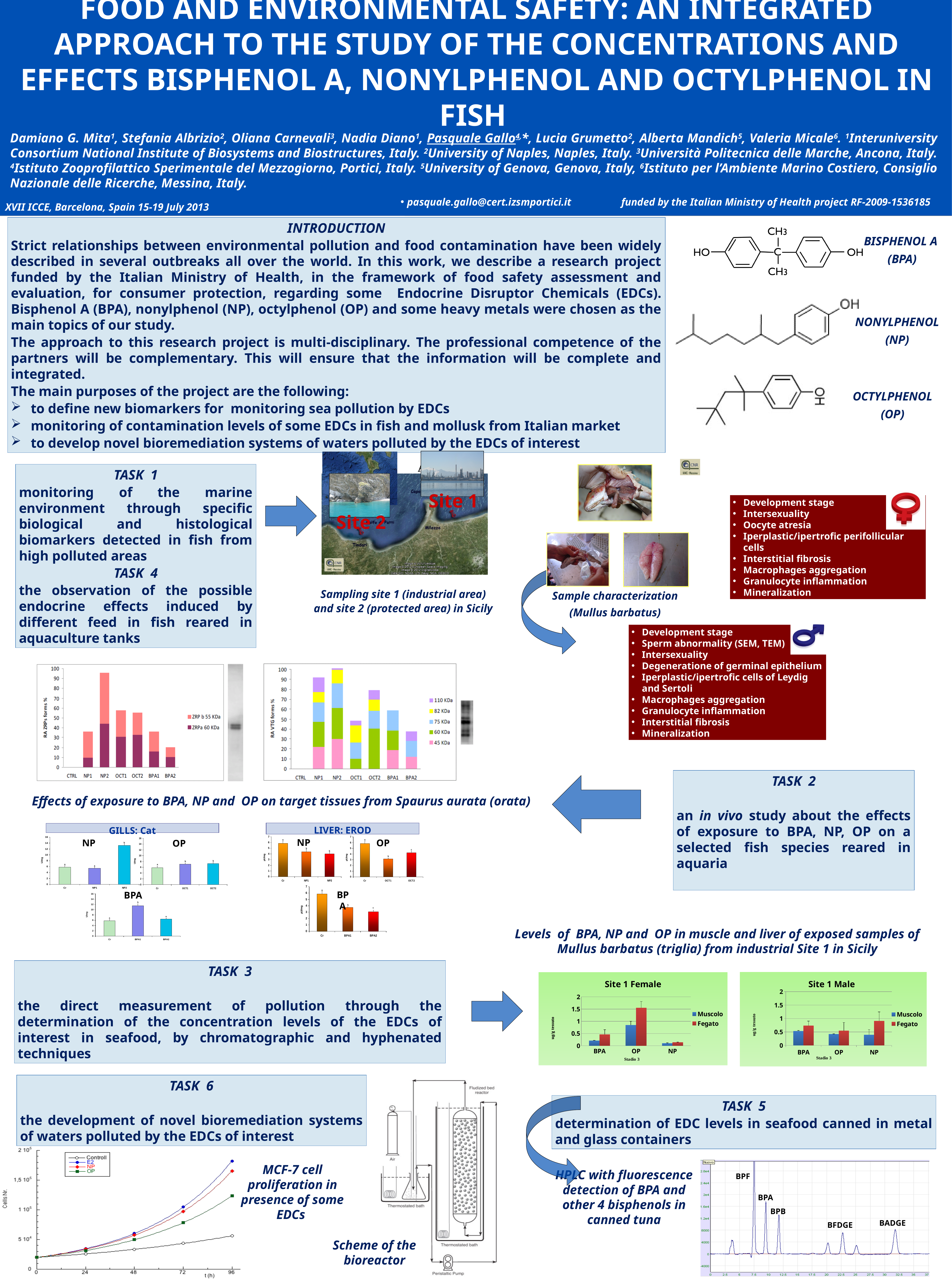
How many categories are shown on the x axis of the 'RA ZRPs forms %' chart? 7 In the 'RA ZRPs forms %' chart, is the total bar for NP2 greater or less than 80? greater What kind of chart is the 'RA ZRPs forms %' chart on the left of the poster? bar chart In the MCF-7 cell proliferation line chart at the bottom left, do the cell numbers rise or fall as t(h) increases? rise In the 'RA ZRPs forms %' chart, is the total bar for BPA2 greater or less than 30? less How many series does the legend of the 'Site 1 Male' chart list? 2 In the 'Site 1 Female' chart, which category has the highest Fegato value? OP How many series does the legend of the 'RA VTG forms %' chart list? 5 In the 'Site 1 Female' chart, which is larger for OP: Muscolo or Fegato? Fegato In the 'RA ZRPs forms %' chart, which category has the tallest bar? NP2 In the 'RA VTG forms %' chart, which category has the tallest bar? NP2 In the 'Site 1 Female' chart, is the Fegato value for OP greater or less than 1? greater